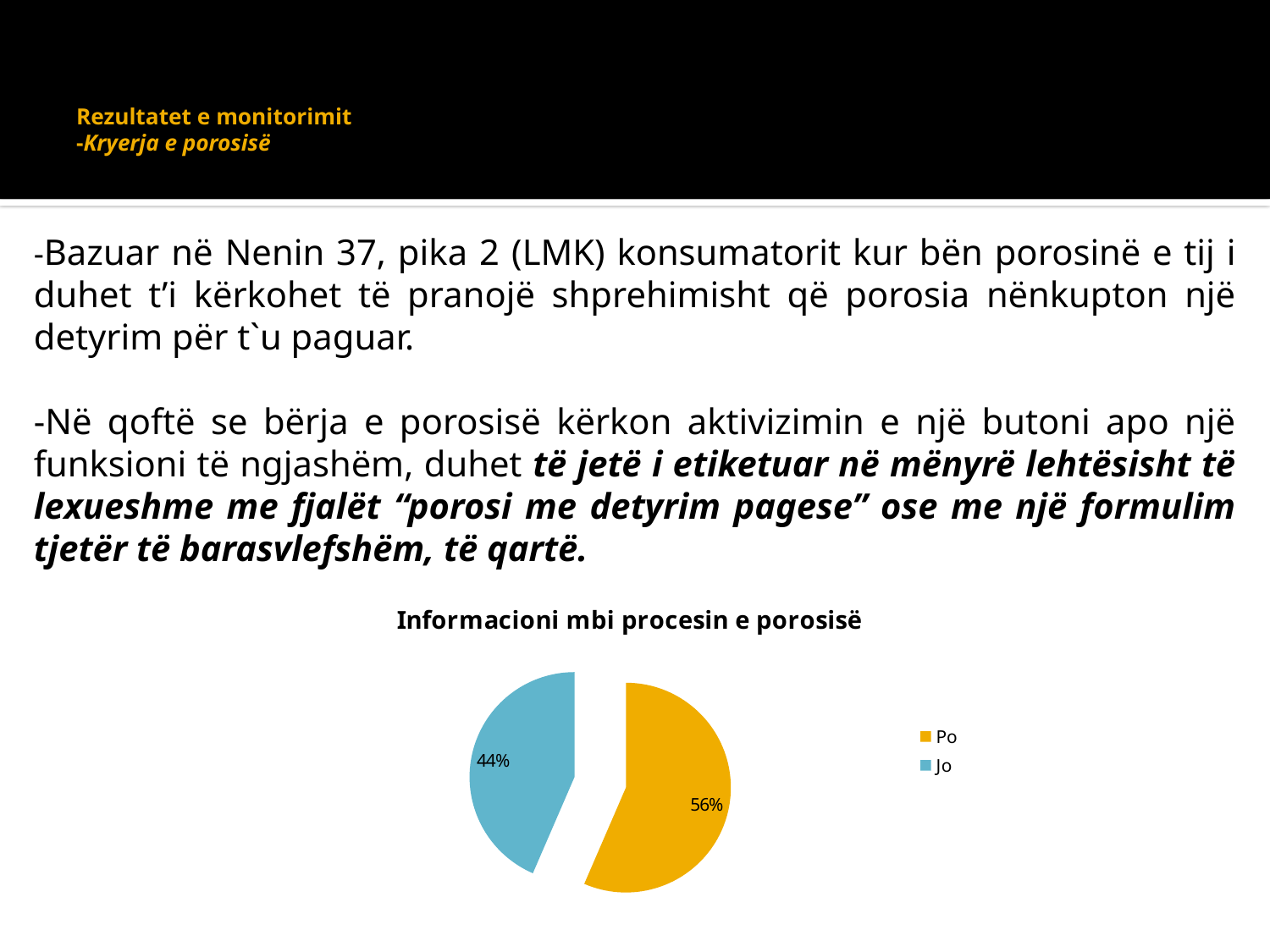
What is the difference in percentage points between the "Po" and "Jo" slices? 12 Which slice of the pie is the smallest? Jo Which slice of the pie is the largest? Po What percentage of the pie is labelled "Po"? 56% Which is larger, the "Po" slice or the "Jo" slice? Po What kind of chart is shown on the slide? pie chart What share of the pie does the "Po" slice represent? 56% What colour is the "Jo" slice? blue How many slices does the pie chart have? 2 What is the title of the chart? Informacioni mbi procesin e porosisë What percentage of the pie is labelled "Jo"? 44% How many entries does the legend list? 2